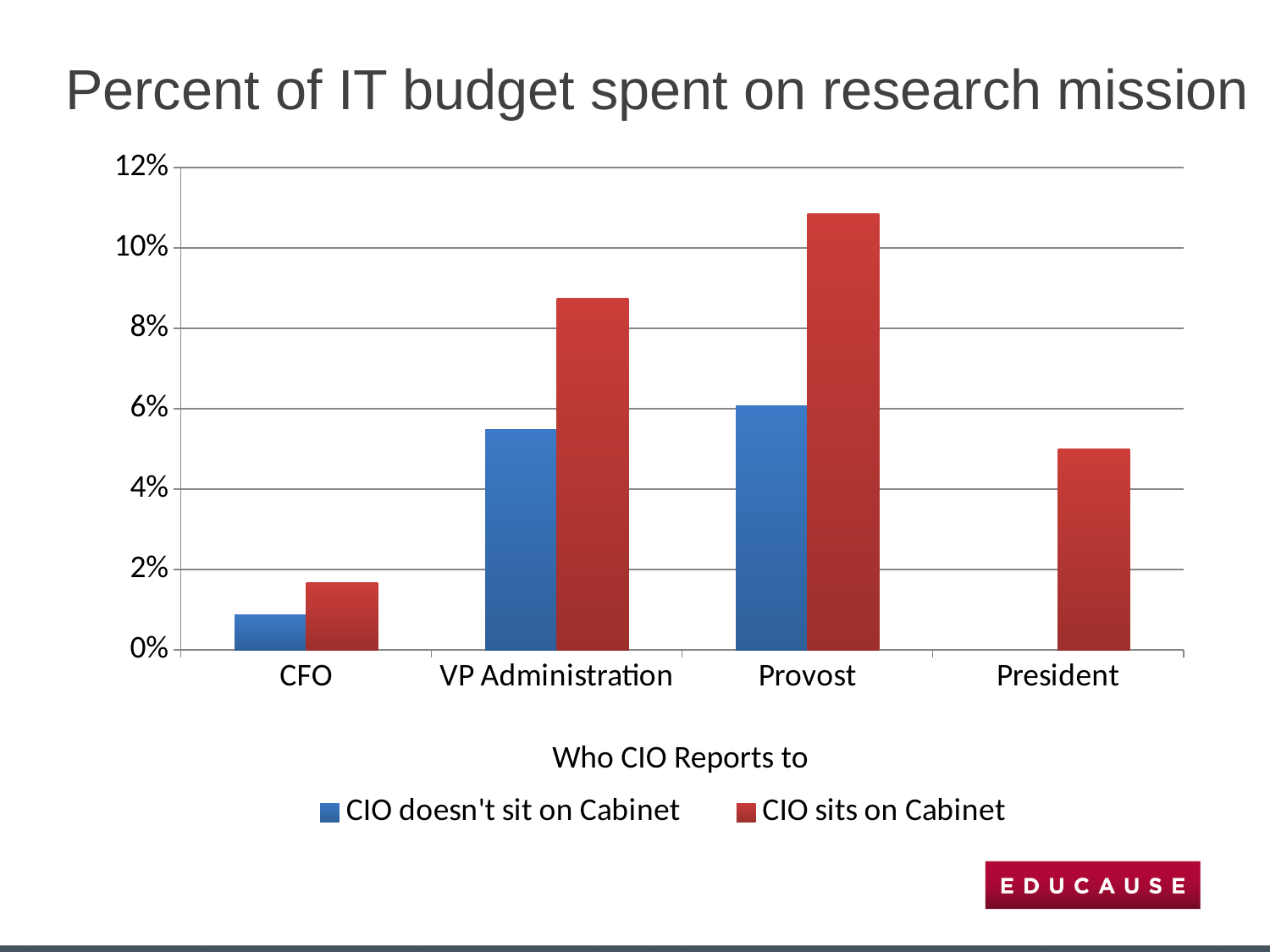
Is the 'CIO doesn't sit on Cabinet' value for CFO greater or less than 2%? less Is the 'CIO sits on Cabinet' value for President greater or less than 4%? greater Is the 'CIO sits on Cabinet' value for VP Administration greater or less than 8%? greater Which colour represents the 'CIO sits on Cabinet' series? Red Which is larger: the 'CIO sits on Cabinet' value for VP Administration or for Provost? Provost For which category is the 'CIO sits on Cabinet' value highest? Provost What kind of chart is shown on the slide? Bar chart What is the title of the x axis? Who CIO Reports to How many series does the legend list? 2 How many categories are shown on the x axis? 4 For which category is the 'CIO sits on Cabinet' value lowest? CFO